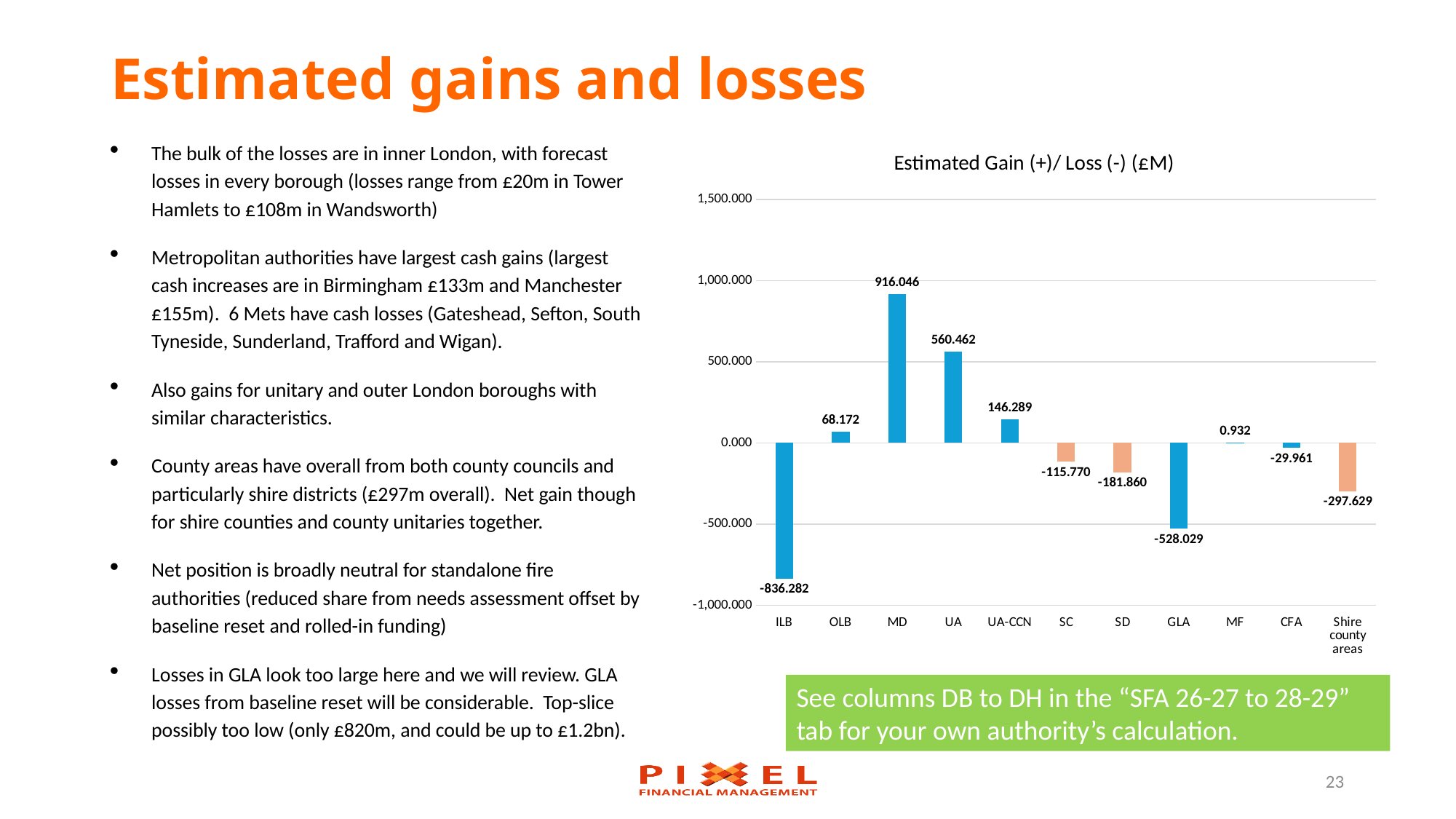
Which category has the lowest value in the chart? ILB What is the estimated gain/loss value for MD? 916.046 What is the title of the chart? Estimated Gain (+)/ Loss (-) (£M) What is the value shown for MF? 0.932 Which category has the highest value in the chart? MD What is the value shown for Shire county areas? -297.629 What is the estimated gain/loss value for ILB? -836.282 What type of chart is shown on the slide? Bar chart How many categories are shown on the x axis of the chart? 11 What is the difference between the values for MD and UA? 355.584 Which has a larger value, SC or SD? SC What is the value shown for GLA? -528.029